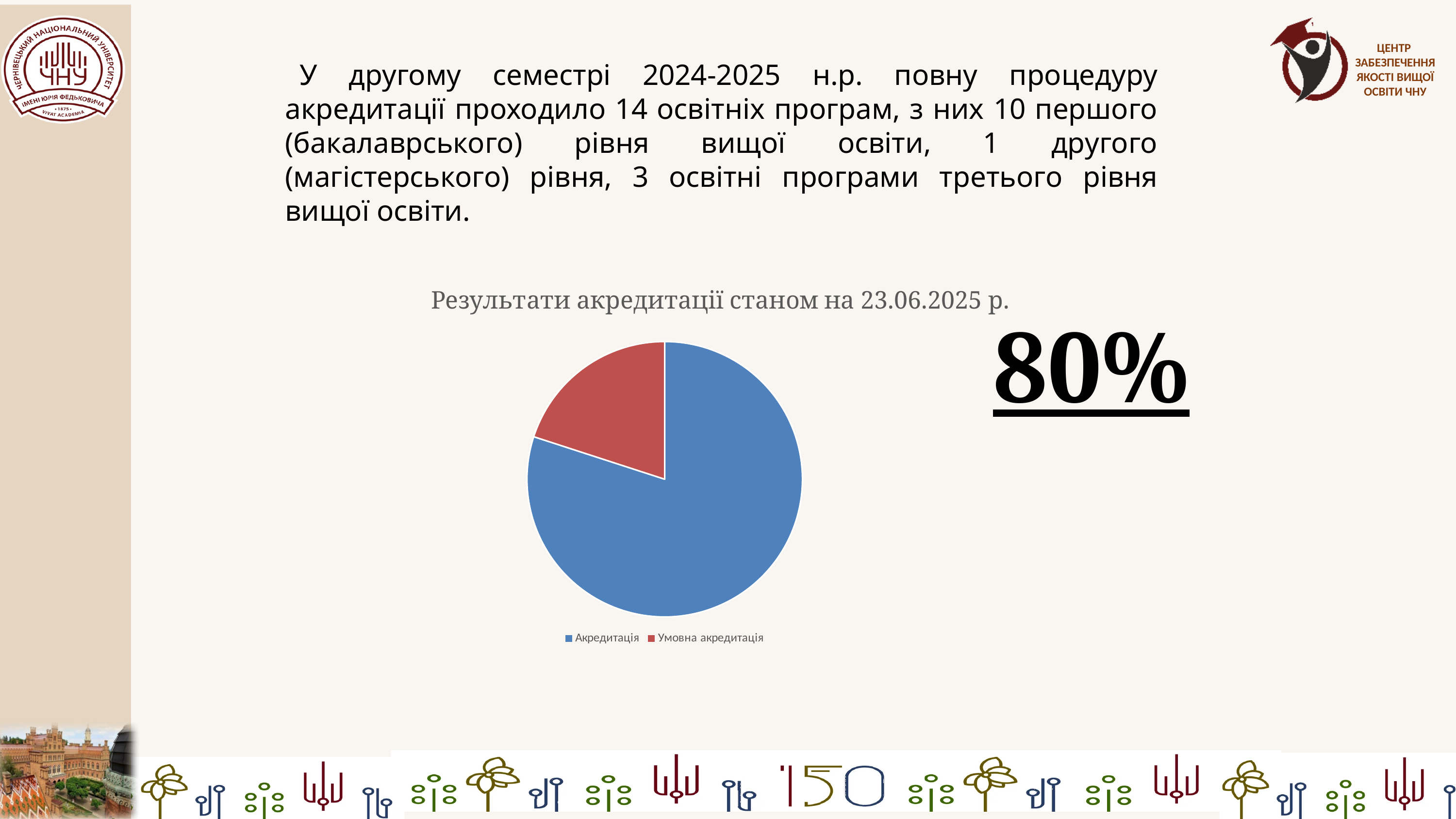
What colour is the slice for Умовна акредитація in the pie chart? red What kind of chart is shown on the slide? pie chart Which slice is larger in the pie chart, Акредитація or Умовна акредитація? Акредитація Which category has the largest slice in the pie chart? Акредитація How many entries does the legend of the pie chart list? 2 What is the title of the pie chart? Результати акредитації станом на 23.06.2025 р. How many slices does the pie chart have? 2 Which category has the smallest slice in the pie chart? Умовна акредитація